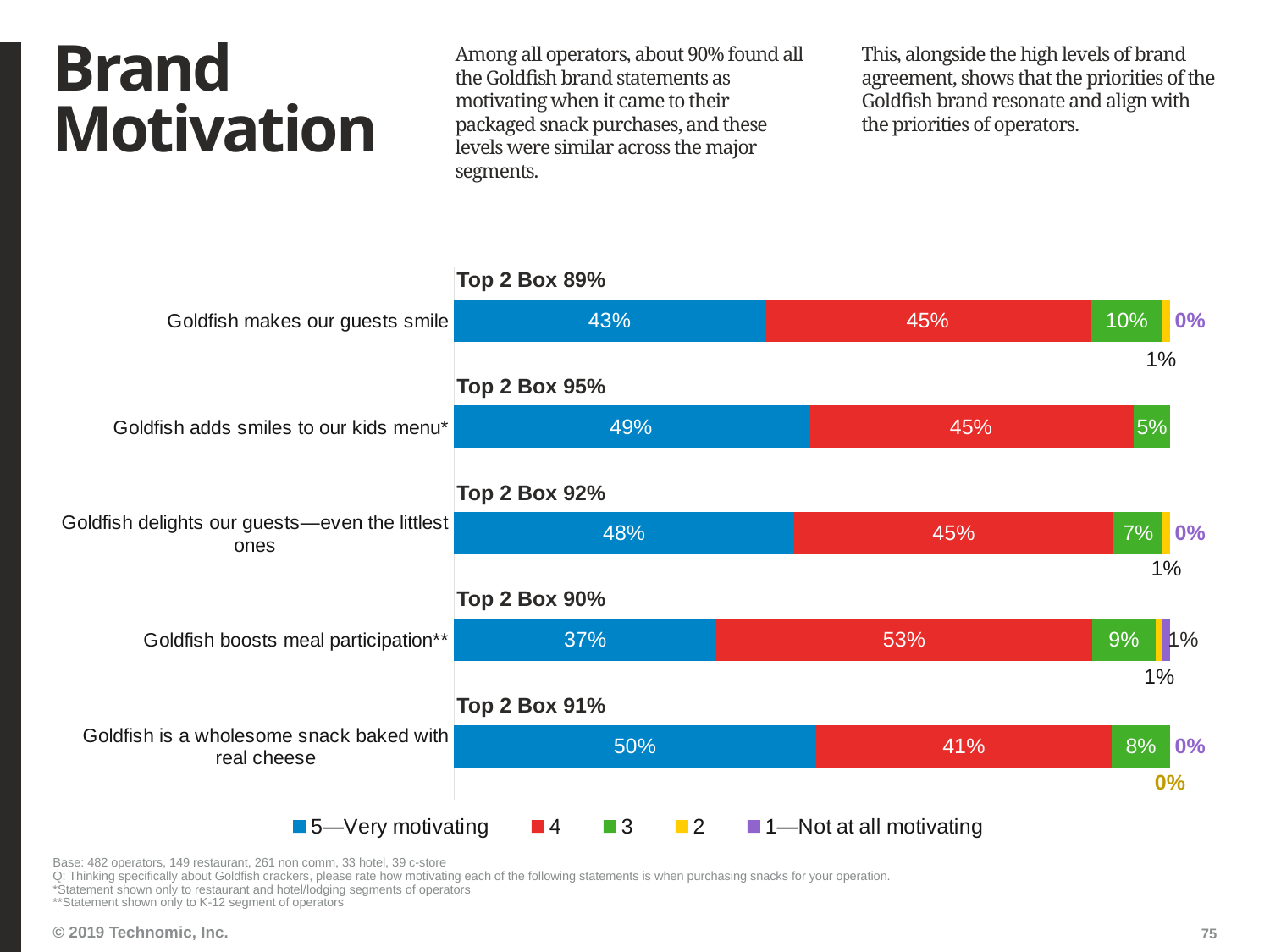
Which statement has the lowest share of operators rating it 5—Very motivating? Goldfish boosts meal participation** What percentage of operators gave a rating of 3 to "Goldfish adds smiles to our kids menu*"? 5% Which statement has the highest share of operators rating it 5—Very motivating? Goldfish is a wholesome snack baked with real cheese Which legend entry is represented by the blue segments? 5—Very motivating Which is larger: the share rating 3 for "Goldfish makes our guests smile" or for "Goldfish delights our guests—even the littlest ones"? Goldfish makes our guests smile What type of chart is shown on the slide? Stacked bar chart How many brand statements are shown in the chart? 5 How many series does the legend list? 5 What percentage of operators rated "Goldfish makes our guests smile" as 5—Very motivating? 43% What is the Top 2 Box score shown for "Goldfish adds smiles to our kids menu*"? 95% What is the difference between the 5—Very motivating share for "Goldfish is a wholesome snack baked with real cheese" and for "Goldfish boosts meal participation**"? 13% What percentage of operators gave a rating of 4 to "Goldfish boosts meal participation**"? 53%